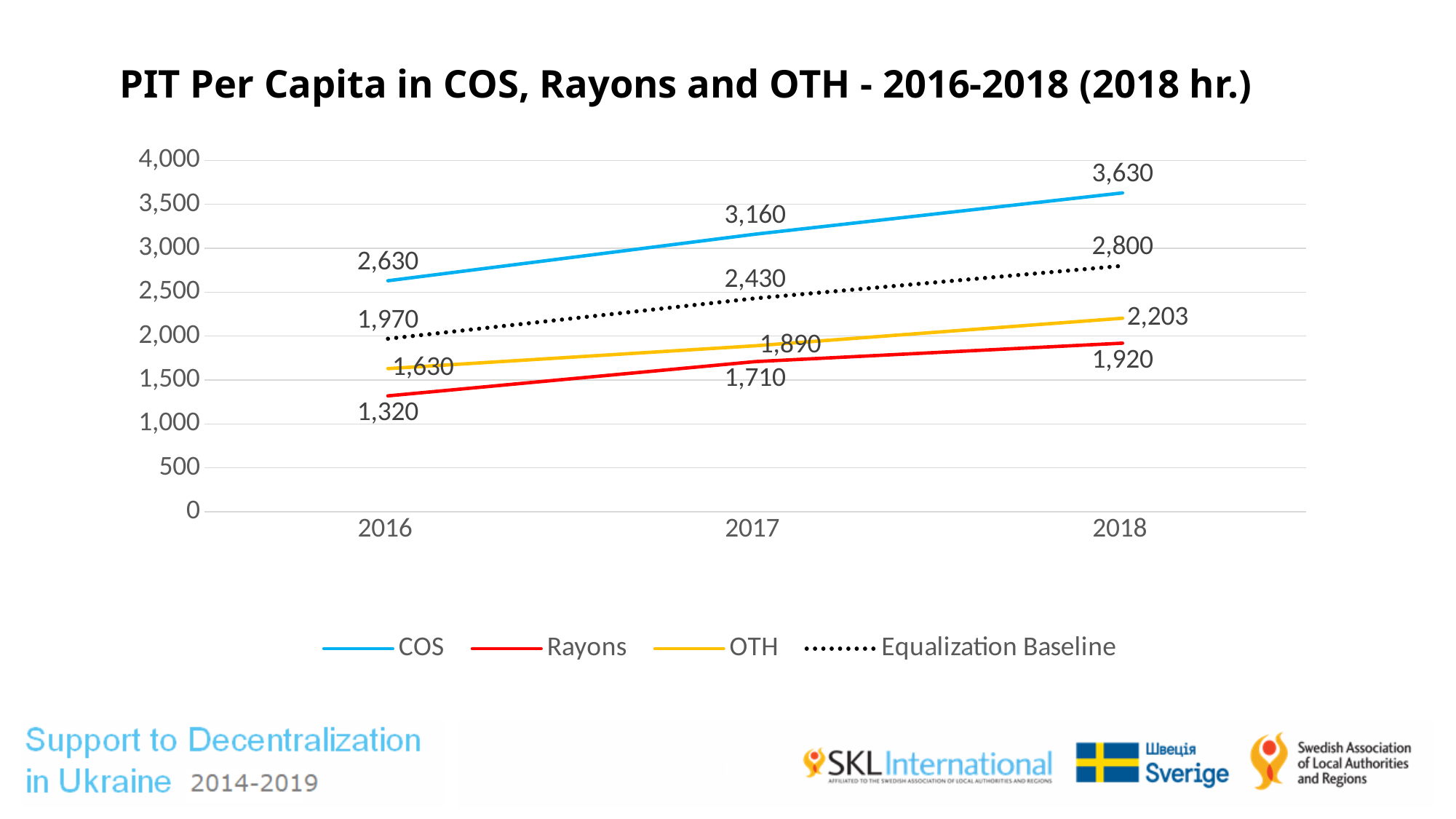
Which series has the highest value in 2018? COS Do the Rayons values rise or fall from 2016 to 2018? Rise What is the PIT per capita for Rayons in 2016? 1,320 Which series has the lowest value in 2016? Rayons What kind of chart is shown on the slide? Line chart How many series does the legend list? 4 Which is larger in 2017, the OTH value or the Rayons value? OTH What is the PIT per capita for OTH in 2018? 2,203 What is the difference between the COS and Rayons values in 2017? 1,450 By how much did the COS value increase from 2016 to 2018? 1,000 What is the Equalization Baseline value in 2017? 2,430 What is the PIT per capita for COS in 2018? 3,630